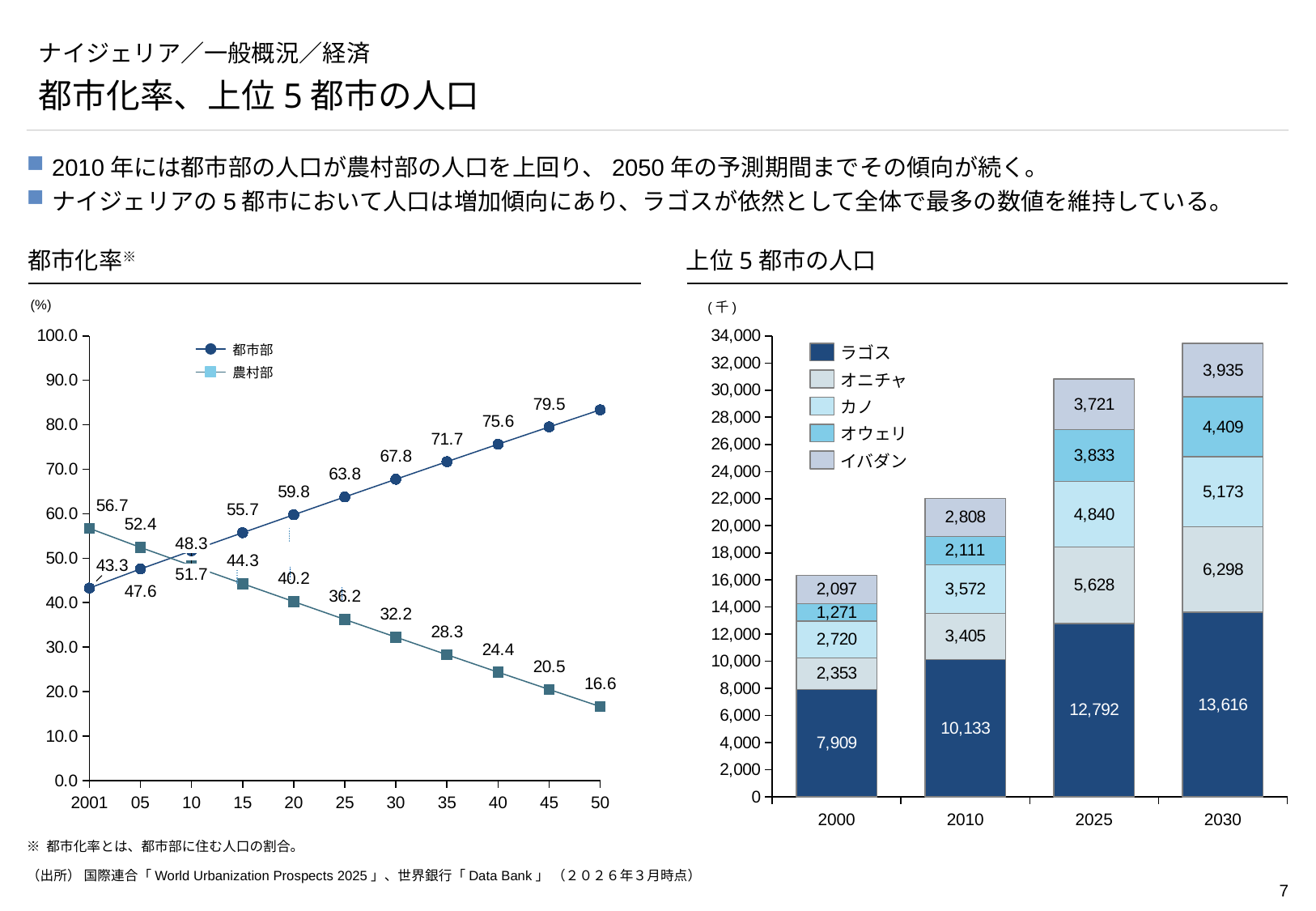
What kind of chart is the 上位5都市の人口 chart on the right? stacked bar chart In the 都市化率 chart on the left, what is the value for 農村部 in 2050? 16.6 In the 上位5都市の人口 chart on the right, what is the value for ラゴス in 2030? 13,616 In the 都市化率 chart on the left, how many years are plotted along the x axis? 11 In the 上位5都市の人口 chart on the right, what is the total of the stacked bar for 2000? 16,350 In the 都市化率 chart on the left, what is the value for 都市部 in 2020? 59.8 In the 都市化率 chart on the left, do the 農村部 values rise or fall from 2001 to 2050? fall In the 上位5都市の人口 chart on the right, which is larger in 2025, オニチャ or カノ? オニチャ In the 上位5都市の人口 chart on the right, what is the value for カノ in 2010? 3,572 In the 都市化率 chart on the left, is the value for 都市部 in 2050 greater or less than 80? greater In the 上位5都市の人口 chart on the right, what is the difference between the ラゴス value in 2030 and in 2000? 5,707 In the 上位5都市の人口 chart on the right, how many series does the legend list? 5